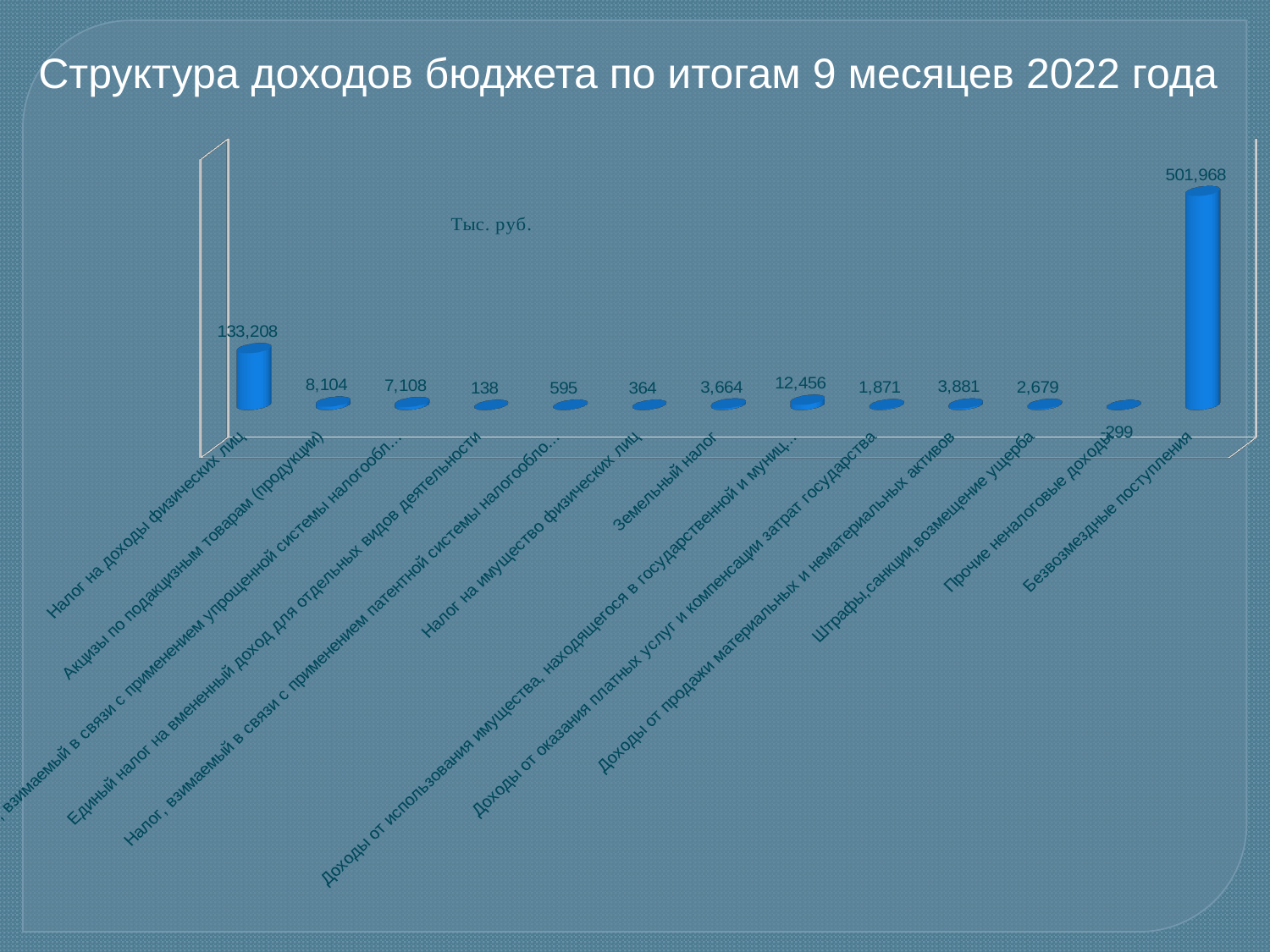
How many categories are shown on the chart? 13 What is the value for Безвозмездные поступления? 501,968 What is the value for Налог на доходы физических лиц? 133,208 What is the difference between the values for Безвозмездные поступления and Налог на доходы физических лиц? 368,760 What kind of chart is shown on the slide? Bar chart What is the difference between the values for Акцизы по подакцизным товарам (продукции) and Налог на имущество физических лиц? 7,740 What is the value for Земельный налог? 3,664 What unit is indicated on the chart? Тыс. руб. Which category has the highest value? Безвозмездные поступления Which is larger: the value for Земельный налог or the value for Доходы от продажи материальных и нематериальных активов? Доходы от продажи материальных и нематериальных активов Which category has the lowest value? Прочие неналоговые доходы What is the value for Штрафы,санкции,возмещение ущерба? 2,679